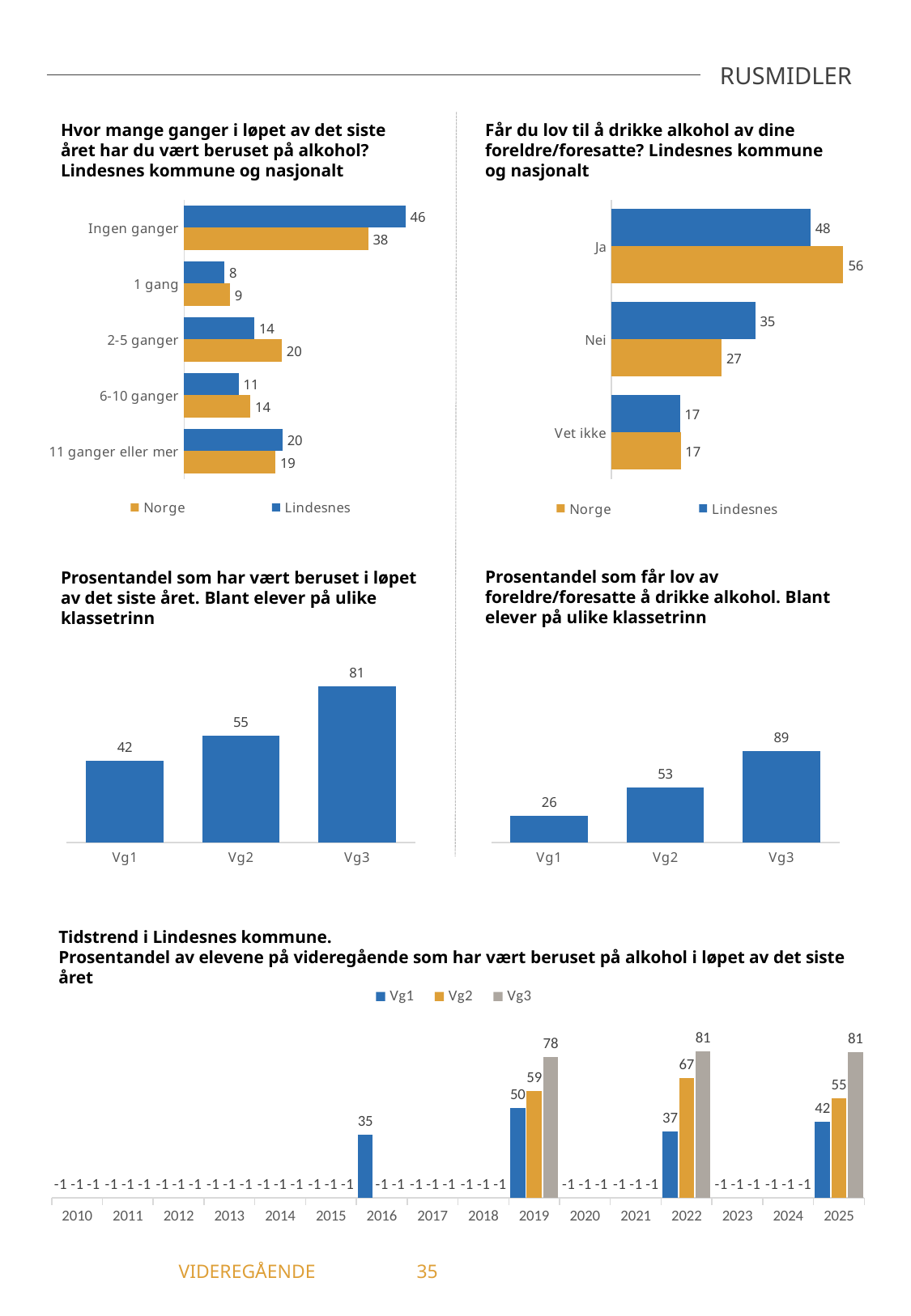
In the top-left chart 'Hvor mange ganger i løpet av det siste året har du vært beruset på alkohol?', what is the difference between Norge and Lindesnes for '2-5 ganger'? 6 In the bottom chart 'Tidstrend i Lindesnes kommune', what is the value for Vg2 in 2022? 67 In the top-left chart 'Hvor mange ganger i løpet av det siste året har du vært beruset på alkohol?', how many categories are shown? 5 In the middle-left chart 'Prosentandel som har vært beruset i løpet av det siste året', which class level has the highest value? Vg3 In the top-right chart 'Får du lov til å drikke alkohol av dine foreldre/foresatte?', which is larger for 'Nei': Lindesnes or Norge? Lindesnes In the middle-right chart 'Prosentandel som får lov av foreldre/foresatte å drikke alkohol', do the values rise or fall from Vg1 to Vg3? rise In the middle-left chart 'Prosentandel som har vært beruset i løpet av det siste året', what is the value for Vg2? 55 In the top-left chart 'Hvor mange ganger i løpet av det siste året har du vært beruset på alkohol?', what is the value for Lindesnes for 'Ingen ganger'? 46 In the bottom chart 'Tidstrend i Lindesnes kommune', what kind of chart is it? bar chart In the top-right chart 'Får du lov til å drikke alkohol av dine foreldre/foresatte?', how many series does the legend list? 2 In the middle-right chart 'Prosentandel som får lov av foreldre/foresatte å drikke alkohol', what is the difference between Vg3 and Vg1? 63 In the top-right chart 'Får du lov til å drikke alkohol av dine foreldre/foresatte?', what is the value for Norge for 'Ja'? 56